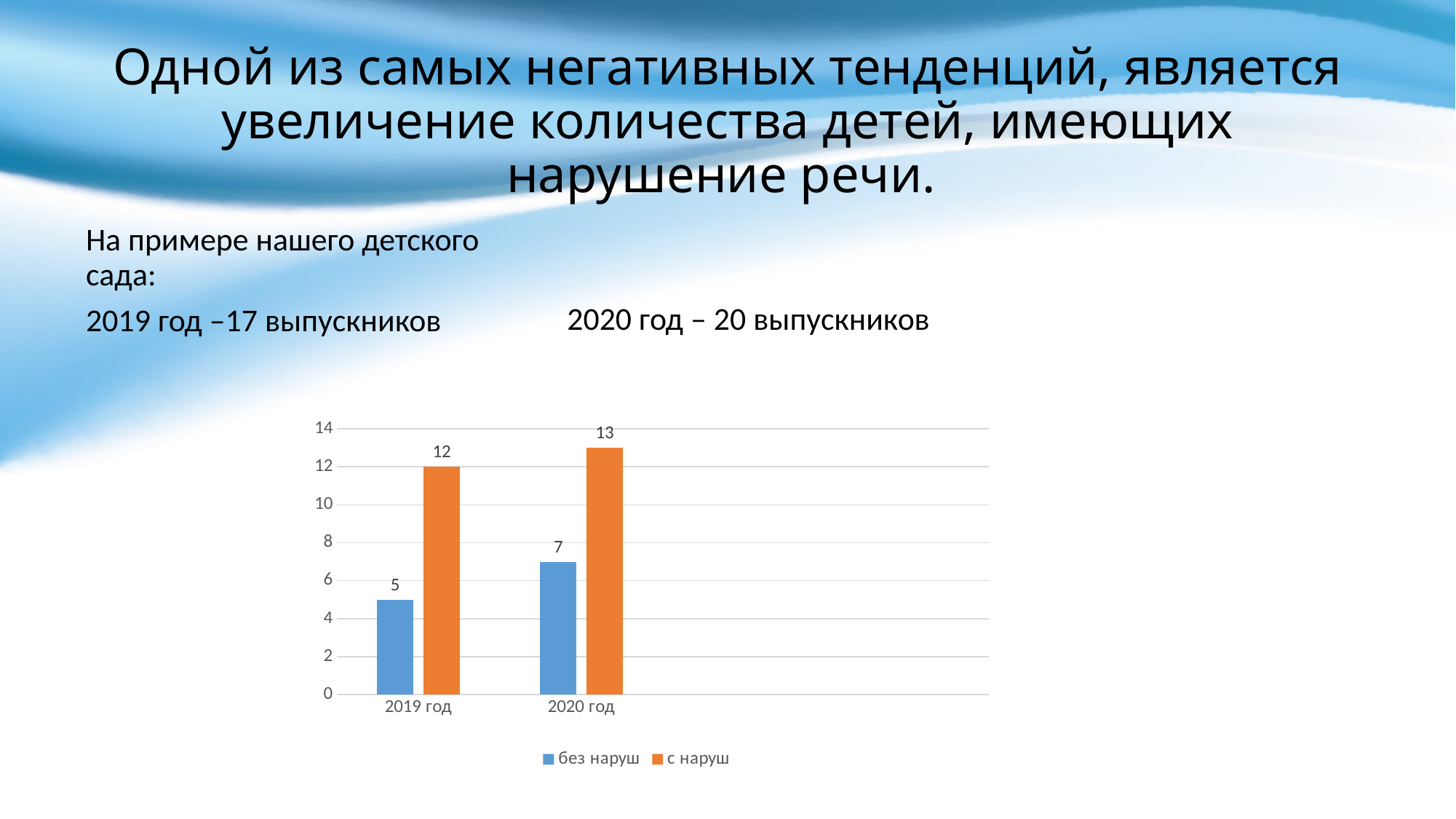
Which category has the lowest value for "без наруш"? 2019 год What is the difference between "с наруш" and "без наруш" in 2019 год? 7 What is the value for "с наруш" in 2019 год? 12 Does the value for "с наруш" rise or fall from 2019 год to 2020 год? rise What is the value for "без наруш" in 2020 год? 7 Which is larger in 2020 год: "без наруш" or "с наруш"? с наруш What is the value for "без наруш" in 2019 год? 5 How many categories are shown on the x axis? 2 Which category has the highest value for "с наруш"? 2020 год What kind of chart is shown on the slide? bar chart How many series does the legend list? 2 What is the value for "с наруш" in 2020 год? 13